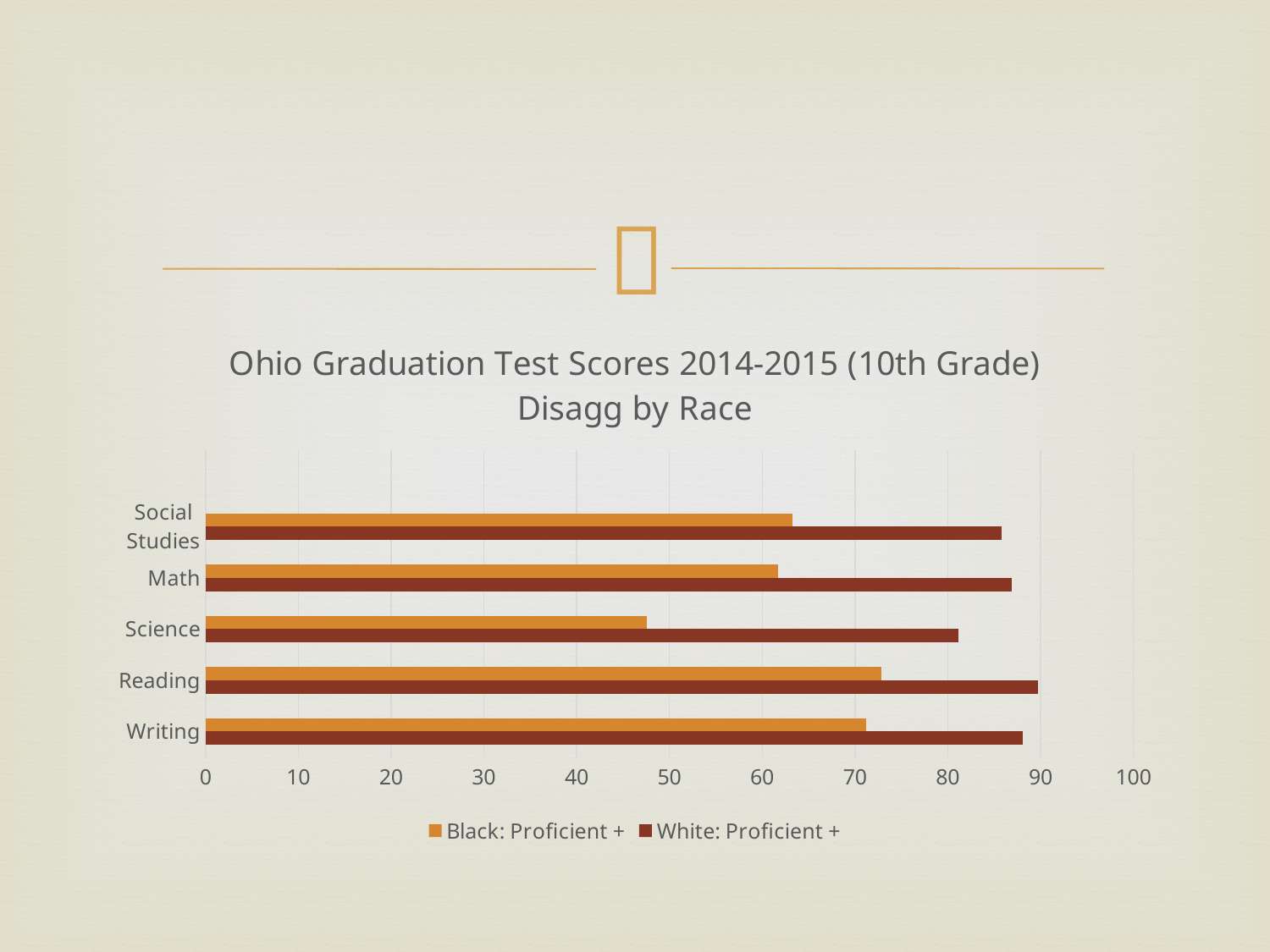
How many subject categories are shown on the chart? 5 What kind of chart is shown on the slide? bar chart Which is larger for Black: Proficient +: Science or Social Studies? Social Studies Is the value for Black: Proficient + in Social Studies greater or less than 60? greater What is the title of the chart? Ohio Graduation Test Scores 2014-2015 (10th Grade) Disagg by Race How many series does the legend list? 2 Which subject has the lowest value for White: Proficient +? Science Which subject has the lowest value for Black: Proficient +? Science Is the value for White: Proficient + in Social Studies greater or less than 80? greater Is the value for Black: Proficient + in Science greater or less than 50? less Which is larger in Math: the value for Black: Proficient + or White: Proficient +? White: Proficient +